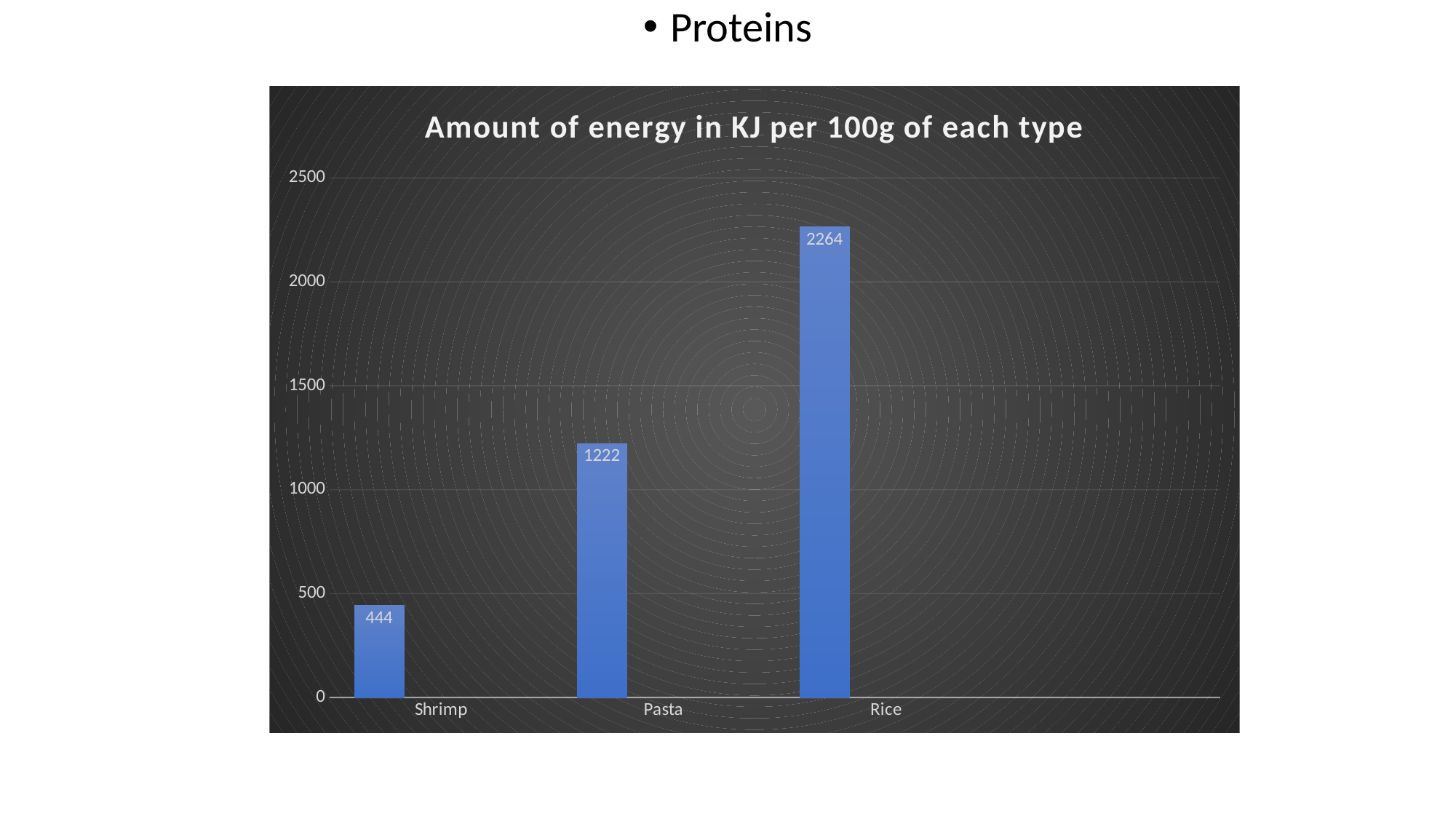
Which category has the highest value? Rice What is the difference between the values for Pasta and Shrimp? 778 Which is larger, the value for Pasta or the value for Shrimp? Pasta Is the value for Rice greater or less than 2000? greater How many categories are shown on the x axis? 3 Which category has the lowest value? Shrimp What is the difference between the values for Rice and Pasta? 1042 What is the title of the chart? Amount of energy in KJ per 100g of each type What is the value for Rice? 2264 What is the value for Shrimp? 444 What is the value for Pasta? 1222 What kind of chart is shown on the slide? bar chart